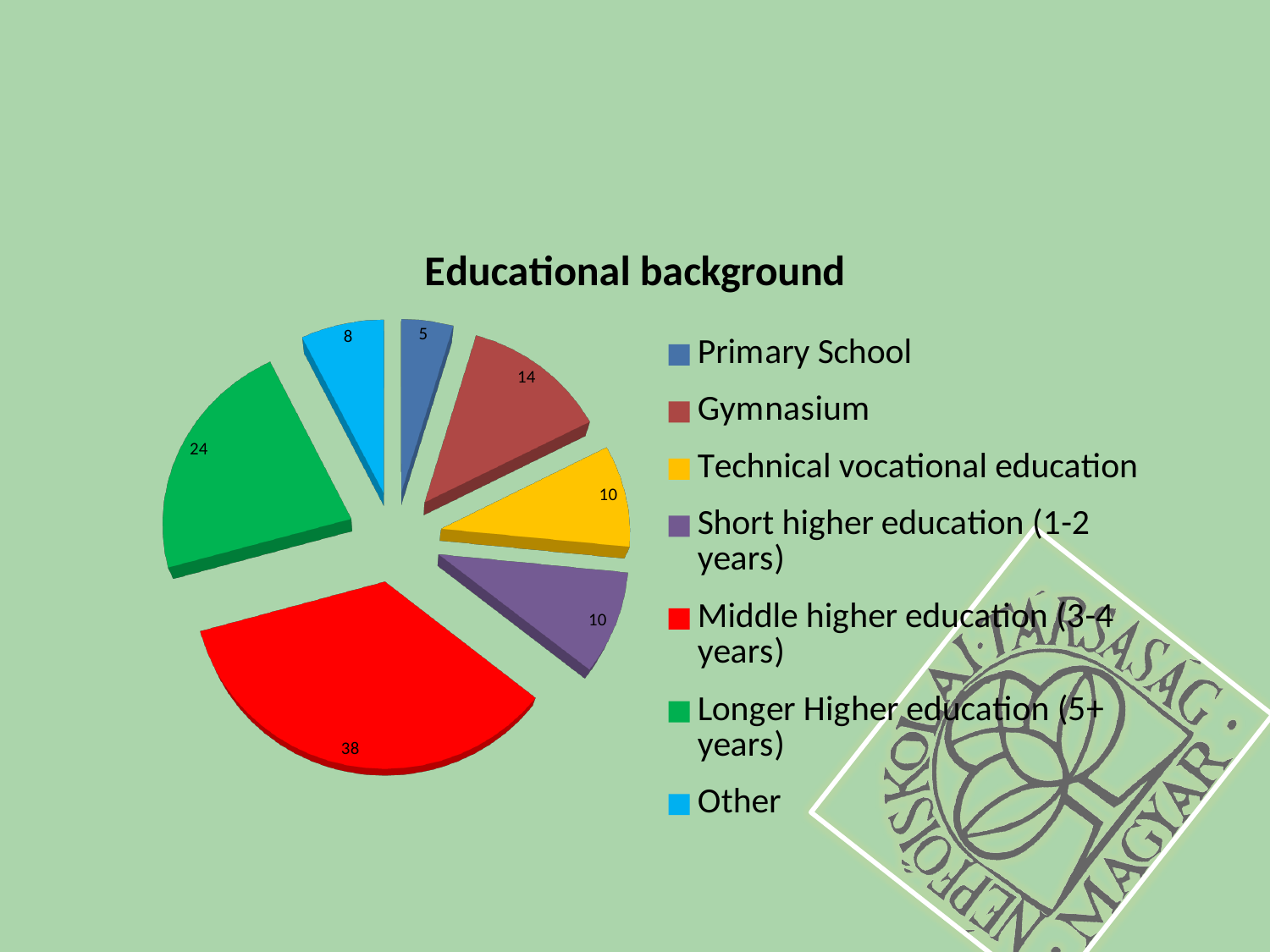
What is the value for Middle higher education (3-4 years)? 38 What is the value for Other? 8 Which category has the largest slice? Middle higher education (3-4 years) What kind of chart is shown on the slide? pie chart What is the title of the chart? Educational background What is the value for Gymnasium? 14 What colour is the slice for Longer Higher education (5+ years)? green Which category has the smallest slice? Primary School What is the value for Primary School? 5 What is the difference between the values for Middle higher education (3-4 years) and Longer Higher education (5+ years)? 14 Which is larger, the value for Gymnasium or the value for Other? Gymnasium How many categories does the pie chart have? 7